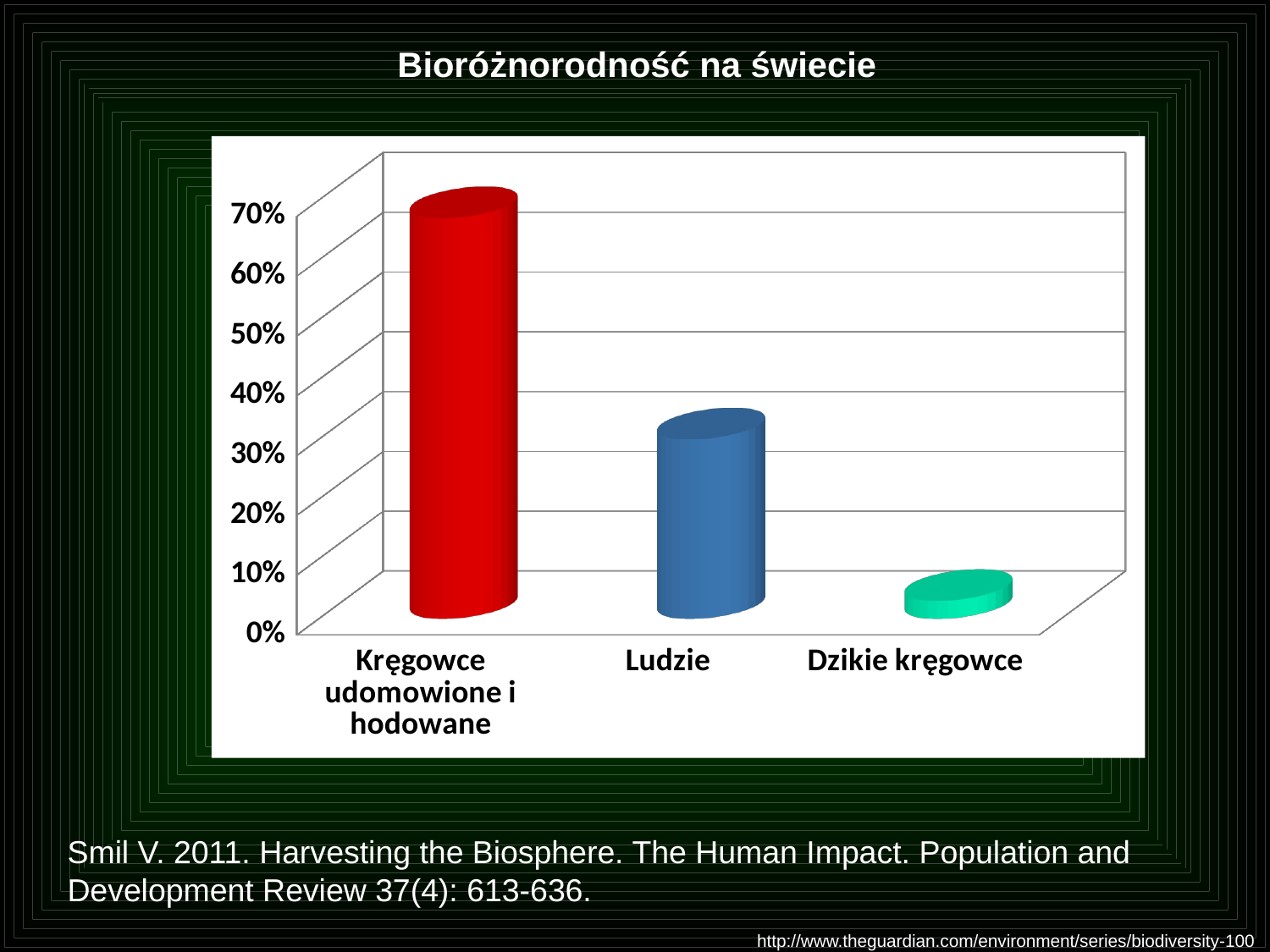
Do the values rise or fall from left to right along the x axis? fall Is the value for Ludzie greater or less than 20%? greater Which category has the highest value in the chart? Kręgowce udomowione i hodowane Which is larger, the value for Ludzie or the value for Dzikie kręgowce? Ludzie What kind of chart is shown on the slide? bar chart Which is larger, the value for Kręgowce udomowione i hodowane or the value for Ludzie? Kręgowce udomowione i hodowane How many categories are shown on the x axis of the chart? 3 Is the value for Ludzie greater or less than 40%? less Which category has the lowest value in the chart? Dzikie kręgowce Is the value for Dzikie kręgowce greater or less than 10%? less What is the title shown above the chart? Bioróżnorodność na świecie